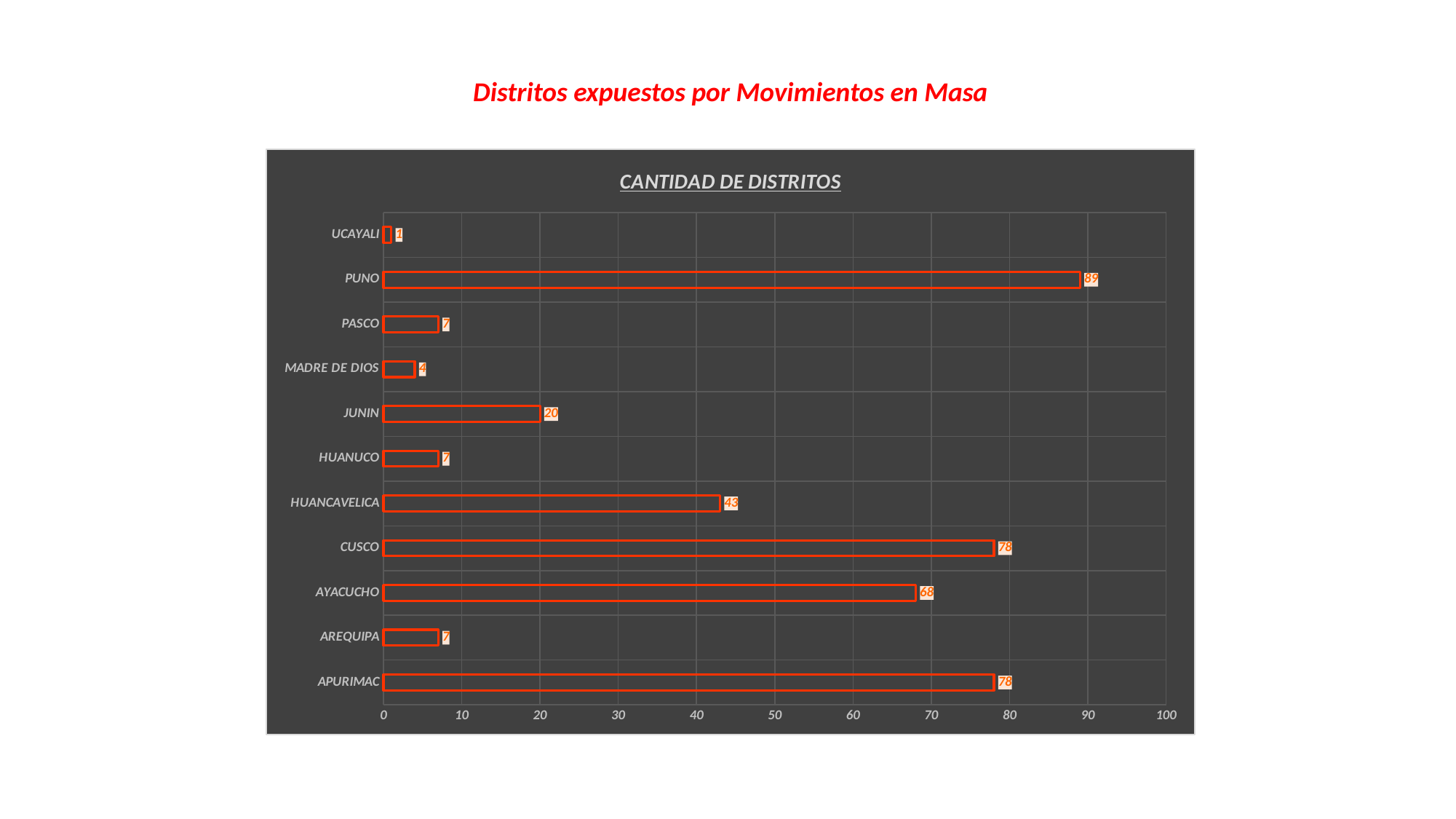
How many categories are shown on the chart? 11 What kind of chart is shown on the slide? bar chart Which category has the highest value? PUNO What is the value for HUANCAVELICA? 43 What is the difference between the values for PUNO and AYACUCHO? 21 What is the title of the chart? CANTIDAD DE DISTRITOS What is the value for MADRE DE DIOS? 4 Which is larger, the value for CUSCO or the value for AYACUCHO? CUSCO What is the value for JUNIN? 20 What is the value for PUNO? 89 Which category has the lowest value? UCAYALI Is the value for HUANCAVELICA greater or less than 50? less